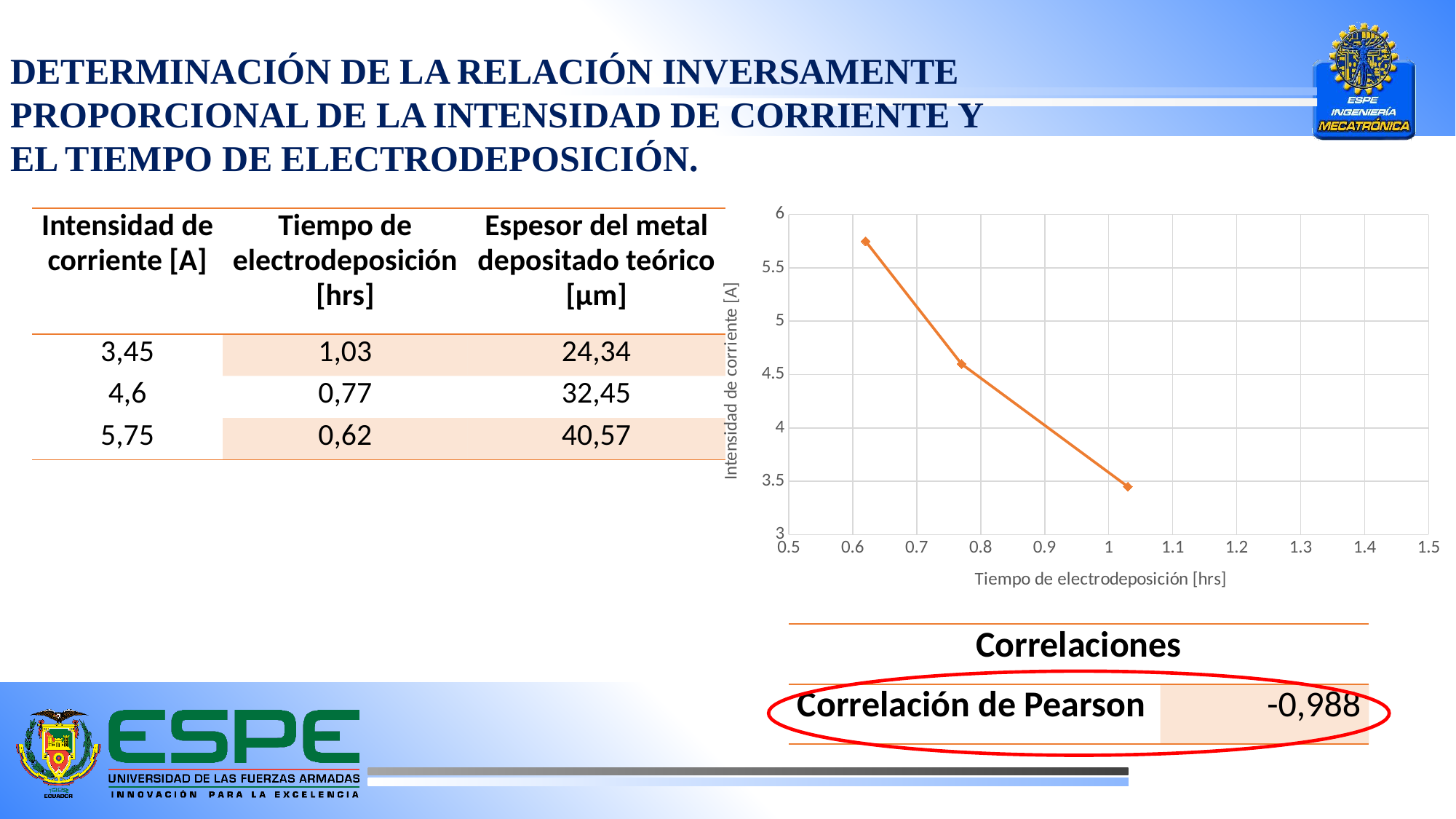
What kind of chart is shown on the right of the slide? line chart Is the current intensity at the leftmost point (about 0.6 hrs) greater or less than 5 A? greater What is the label of the x axis of the chart? Tiempo de electrodeposición [hrs] Is the current intensity at the middle point (about 0.8 hrs) greater or less than 4 A? greater According to the table on the slide, what current intensity corresponds to an electrodeposition time of 1,03 hrs? 3,45 Which is larger: the current intensity at 0,62 hrs or at 0,77 hrs? 0,62 hrs What is the label of the y axis of the chart? Intensidad de corriente [A] According to the table on the slide, what electrodeposition time corresponds to a current intensity of 5,75 A? 0,62 Is the current intensity at the rightmost point (about 1 hr) greater or less than 4 A? less Which plotted point has the highest current intensity: the one at the smallest time or the one at the largest time? the one at the smallest time Does the current intensity rise or fall as the electrodeposition time increases along the x axis? fall How many data points are plotted on the chart? 3